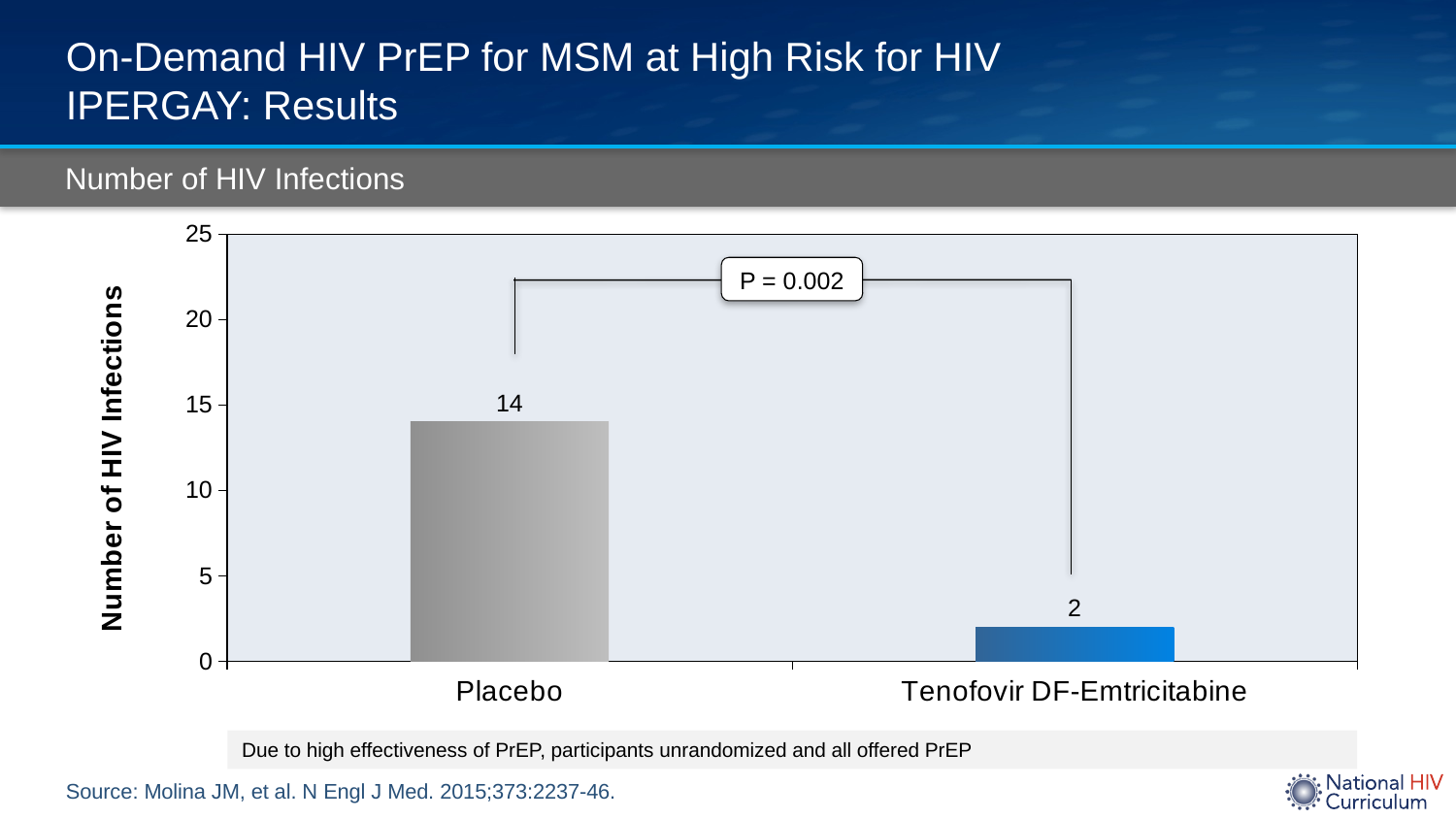
How many groups are shown on the x axis of the chart? 2 What is the number of HIV infections for the Placebo group? 14 What is the number of HIV infections for the Tenofovir DF-Emtricitabine group? 2 What is the P value shown on the chart? P = 0.002 What kind of chart is shown on the slide? Bar chart What is the label of the y axis? Number of HIV Infections What is the difference in the number of HIV infections between the Placebo and Tenofovir DF-Emtricitabine groups? 12 Is the value for Placebo greater or less than 10? greater Which group has the lowest number of HIV infections? Tenofovir DF-Emtricitabine Which group has more HIV infections, Placebo or Tenofovir DF-Emtricitabine? Placebo Which group has the highest number of HIV infections? Placebo Is the value for Tenofovir DF-Emtricitabine greater or less than 5? less